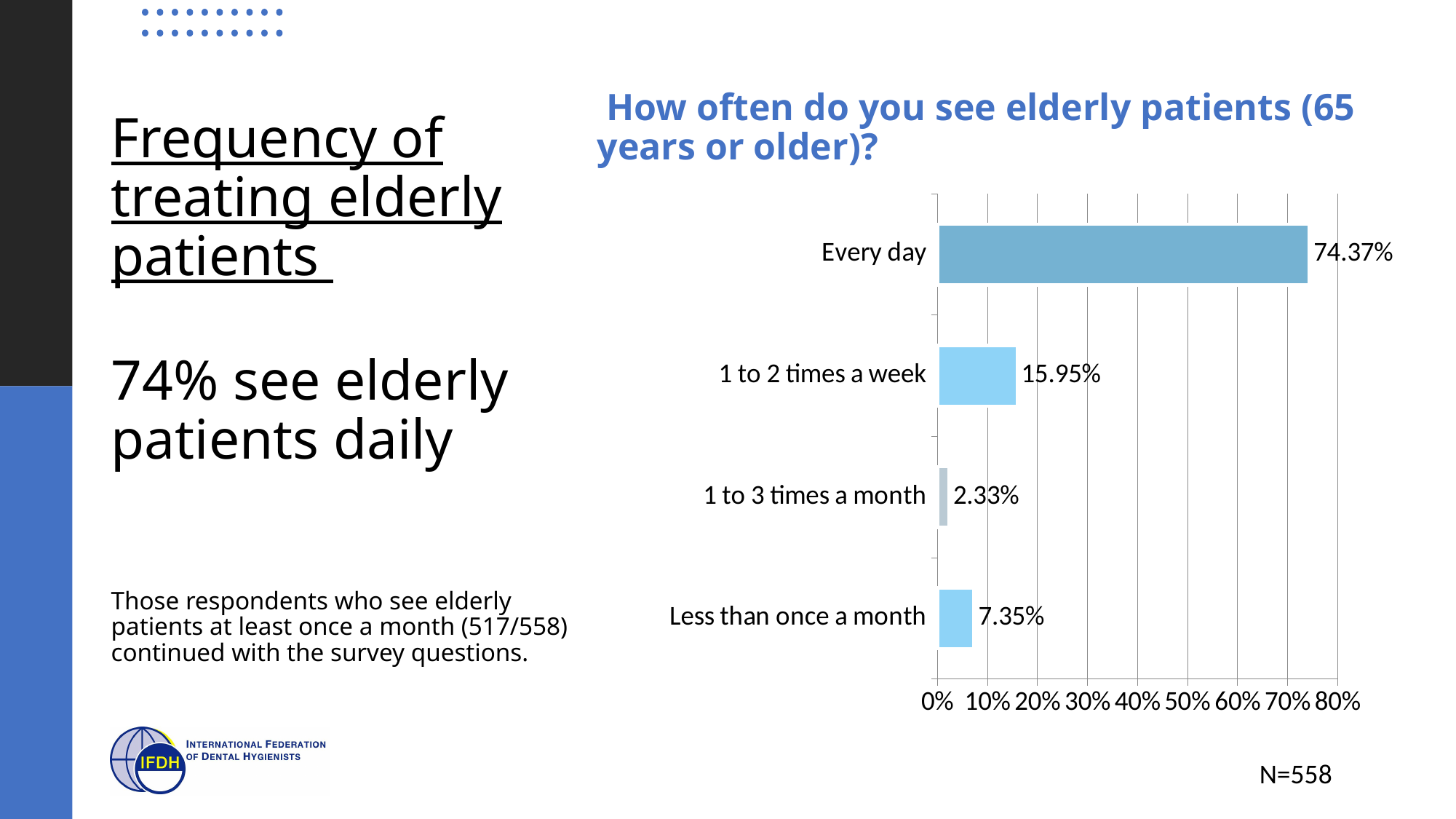
Is the value for 'Every day' greater or less than 70%? greater Which category has the highest value? Every day What percentage of respondents see elderly patients every day? 74.37% What is the title of the chart? How often do you see elderly patients (65 years or older)? What is the value for 'Less than once a month'? 7.35% How many categories are shown in the chart? 4 Which is larger: 'Less than once a month' or '1 to 3 times a month'? Less than once a month Which category has the lowest value? 1 to 3 times a month What is the difference between the 'Every day' and '1 to 2 times a week' values? 58.42% What is the value for '1 to 2 times a week'? 15.95% What type of chart is shown on the slide? Bar chart What is the value for '1 to 3 times a month'? 2.33%